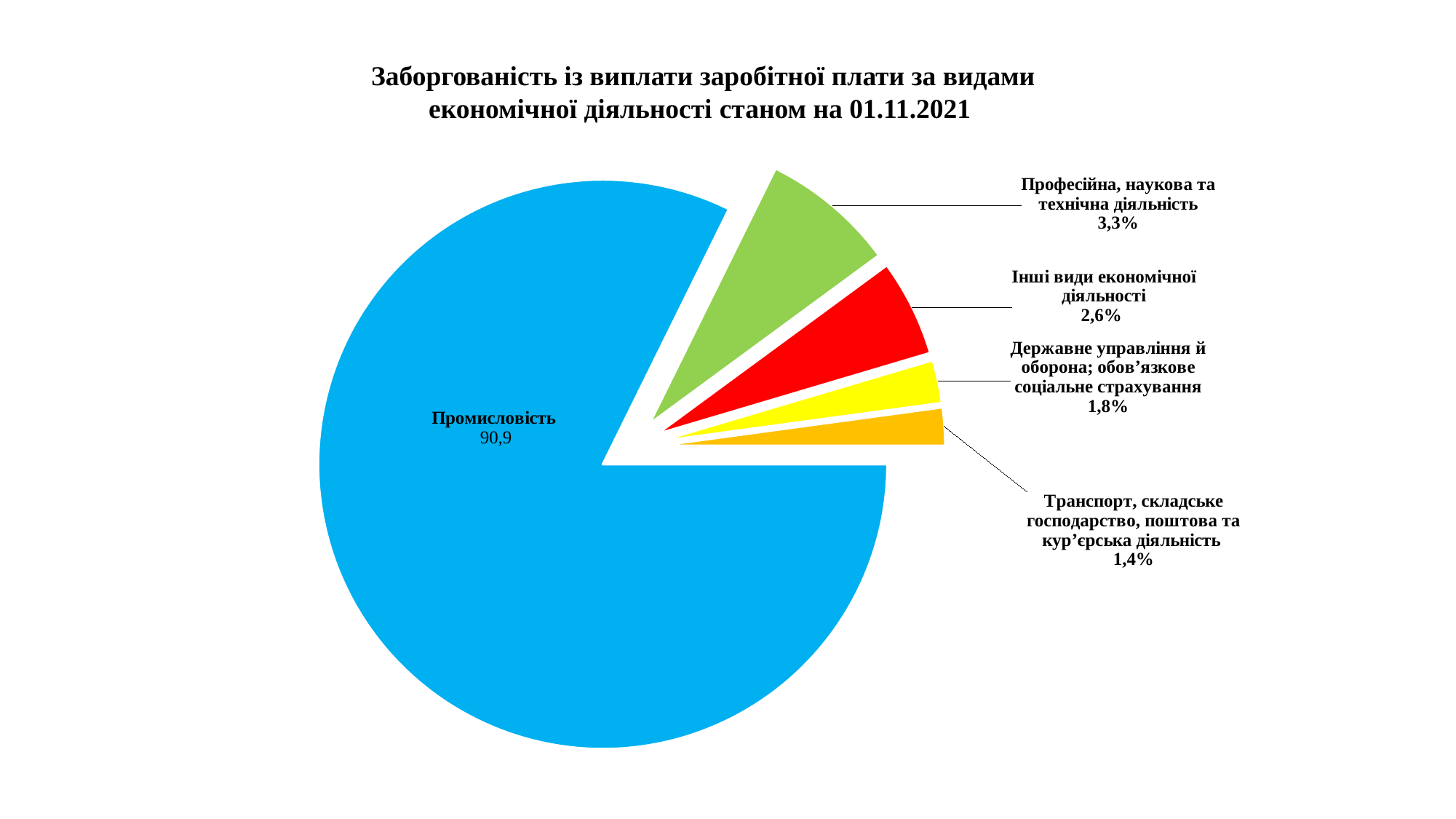
Which category has the smallest slice of the pie? Транспорт, складське господарство, поштова та кур’єрська діяльність Which category has the largest slice of the pie? Промисловість What kind of chart is shown on the slide? pie chart What is the difference between the share for Професійна, наукова та технічна діяльність and the share for Транспорт, складське господарство, поштова та кур’єрська діяльність? 1,9% What is the title of the chart? Заборгованість із виплати заробітної плати за видами економічної діяльності станом на 01.11.2021 What share is shown for Державне управління й оборона; обов’язкове соціальне страхування? 1,8% What share is shown for Транспорт, складське господарство, поштова та кур’єрська діяльність? 1,4% What share is shown for Інші види економічної діяльності? 2,6% Which is larger: the share for Професійна, наукова та технічна діяльність or the share for Інші види економічної діяльності? Професійна, наукова та технічна діяльність How many slices does the pie chart have? 5 What share is shown for Професійна, наукова та технічна діяльність? 3,3% What value is shown for Промисловість? 90,9